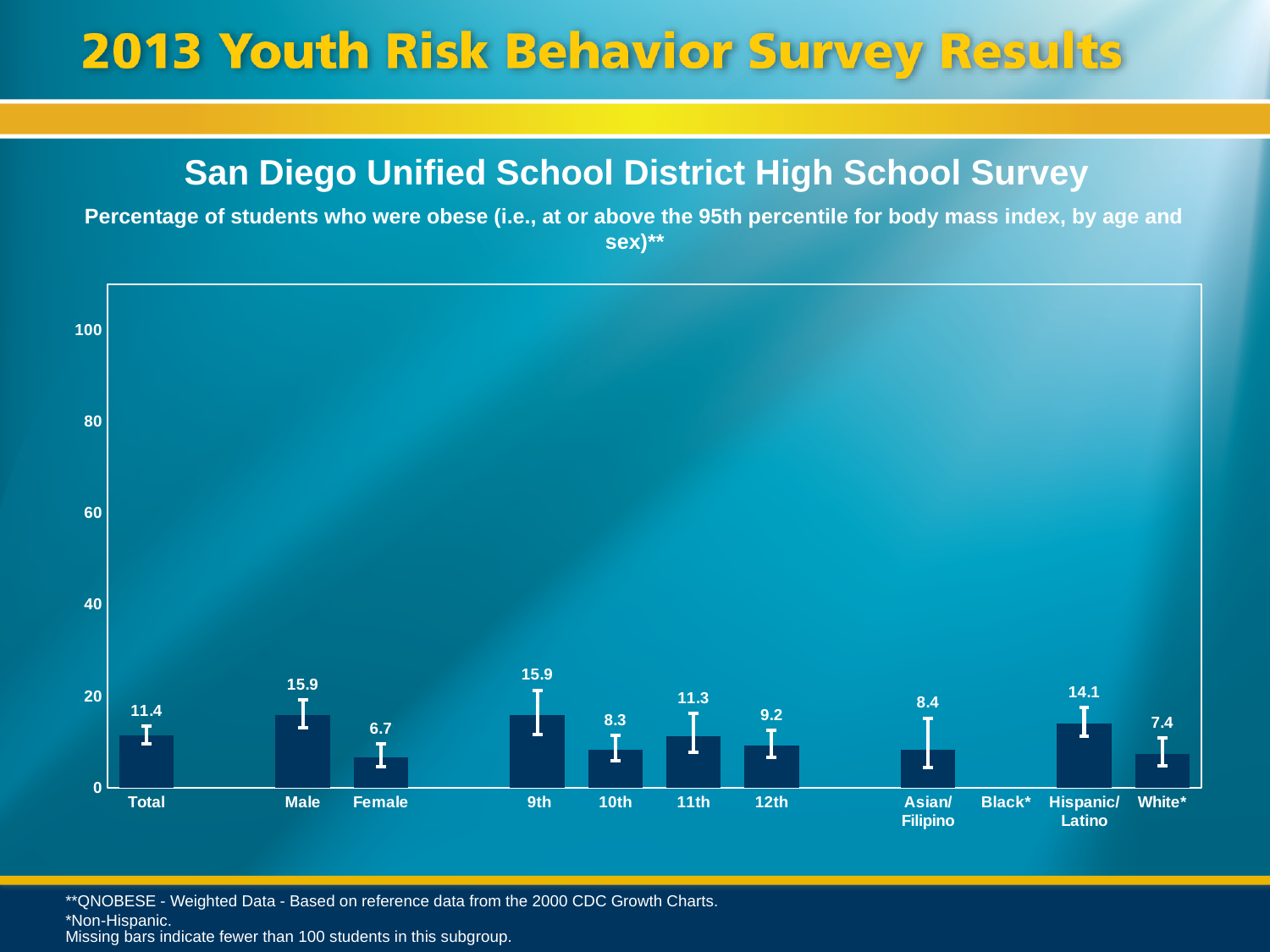
Which category label has no bar plotted? Black* What is the value for Total? 11.4 What is the value for 10th grade? 8.3 What is the value for Female? 6.7 Which grade has the highest value among 9th, 10th, 11th and 12th? 9th Which category has the lowest plotted value? Female Which is larger, the value for 11th grade or the value for 12th grade? 11th How many bars are plotted on the chart? 10 What is the value for Hispanic/Latino? 14.1 What is the difference between the values for Male and Female? 9.2 What kind of chart is shown? bar chart Is the value for Male greater or less than 20? less